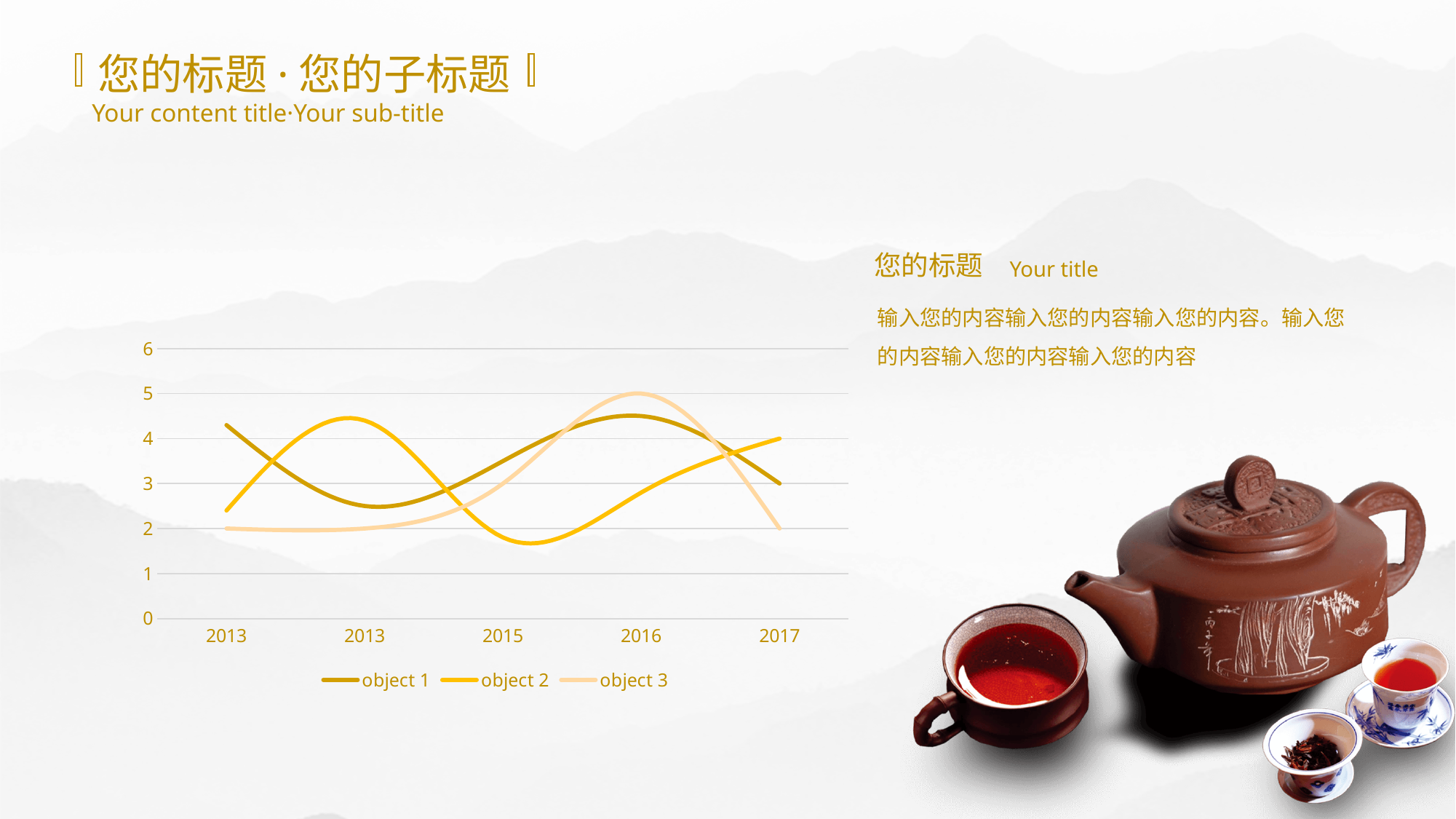
What is the value of object 3 in 2017? 2 What is the value of object 1 in 2017? 3 What kind of chart is shown on the slide? line chart How many series does the chart legend list? 3 Is the value for object 1 in 2016 greater or less than 4? greater Which series has the highest value in 2016? object 3 What is the value of object 3 in 2016? 5 Does object 3 rise or fall from 2016 to 2017? fall In 2017, which is larger, object 1 or object 2? object 2 What is the value of object 2 in 2017? 4 How many points are there along the x axis of the chart? 5 What is the difference between object 2 and object 1 in 2017? 1